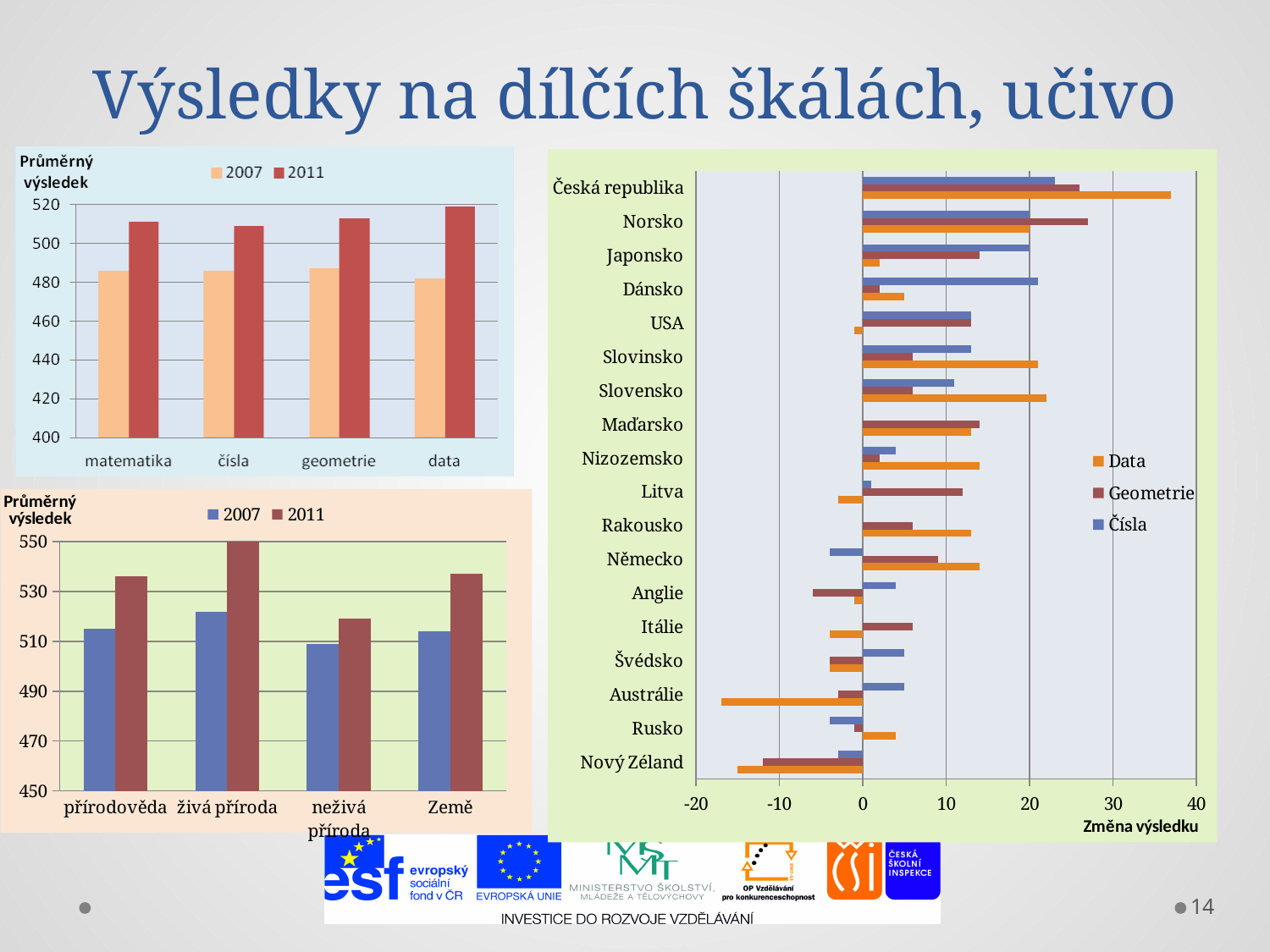
In the right-hand chart, which country has the highest Data value? Česká republika In the bottom-left chart, which category has the highest 2011 value? živá příroda In the right-hand chart, how many series does the legend list? 3 In the bottom-left chart, how many categories are shown on the x axis? 4 In the top-left chart, is the 2007 value for data greater or less than 500? less In the top-left chart, is the 2011 value for matematika greater or less than 500? greater In the bottom-left chart, is the 2011 value for živá příroda greater or less than 530? greater In the bottom-left chart, which is larger for Země: the 2007 value or the 2011 value? 2011 In the top-left chart, which category has the highest 2011 value? data What kind of chart is the top-left chart with categories matematika, čísla, geometrie and data? bar chart In the top-left chart, how many series does the legend list? 2